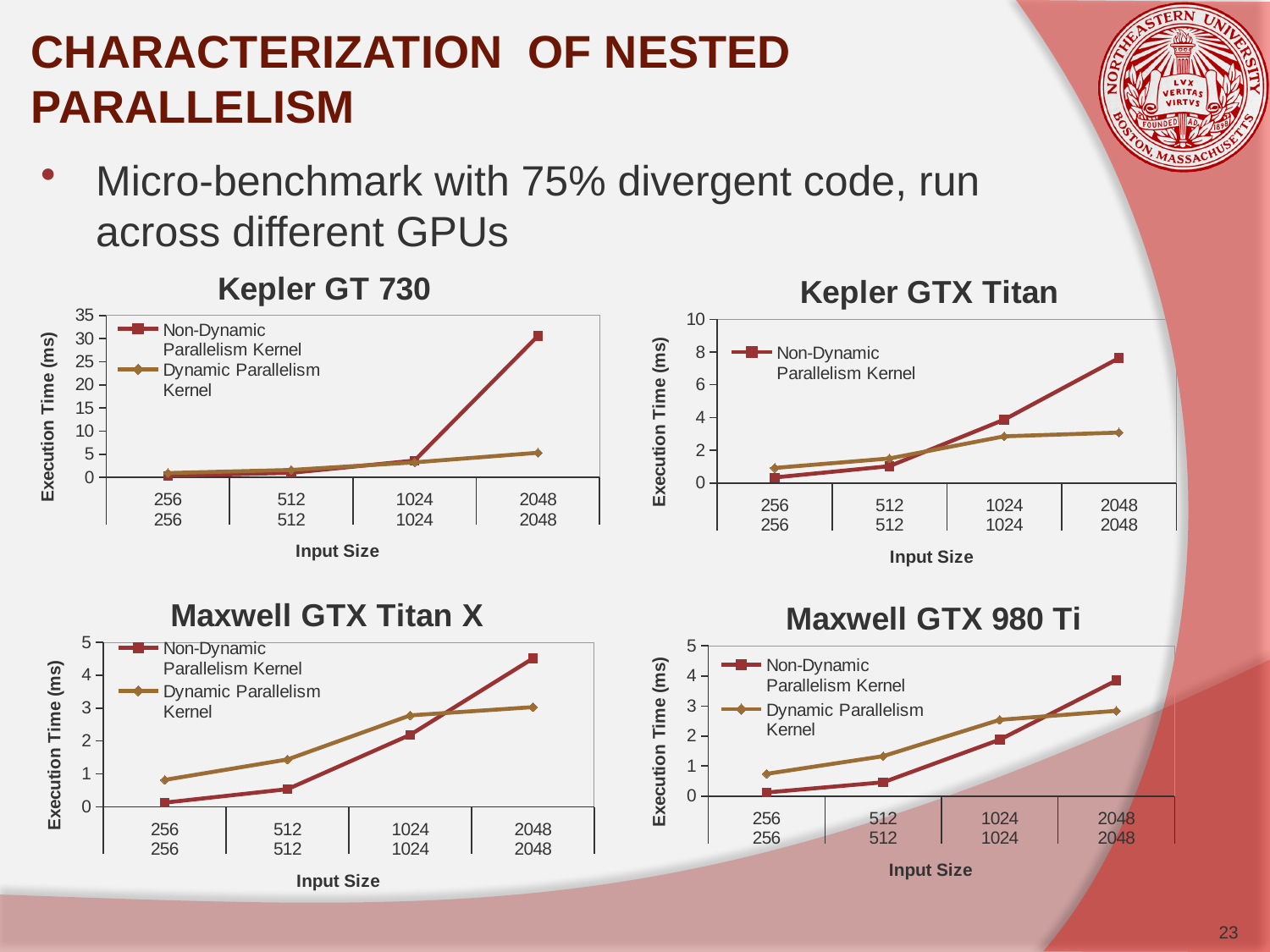
What is the y-axis label on the Maxwell GTX 980 Ti chart? Execution Time (ms) In the Kepler GT 730 chart, is the value for the Non-Dynamic Parallelism Kernel at input size 2048 greater or less than 25? greater In the Kepler GT 730 chart, how many input sizes are plotted along the x axis? 4 In the Maxwell GTX Titan X chart, is the value for the Non-Dynamic Parallelism Kernel at input size 2048 greater or less than 4? greater In the Kepler GTX Titan chart, is the value for the Non-Dynamic Parallelism Kernel at input size 2048 greater or less than 6? greater In the Maxwell GTX 980 Ti chart, does the execution time of the Non-Dynamic Parallelism Kernel rise or fall as input size increases? rise In the Maxwell GTX 980 Ti chart, which series has the larger value at input size 2048? Non-Dynamic Parallelism Kernel In the Kepler GTX Titan chart, at which input size does the Non-Dynamic Parallelism Kernel reach its highest execution time? 2048 What kind of chart is the Kepler GT 730 chart? line chart In the Kepler GT 730 chart, how many series does the legend list? 2 In the Maxwell GTX Titan X chart, which series has the larger value at input size 1024? Dynamic Parallelism Kernel